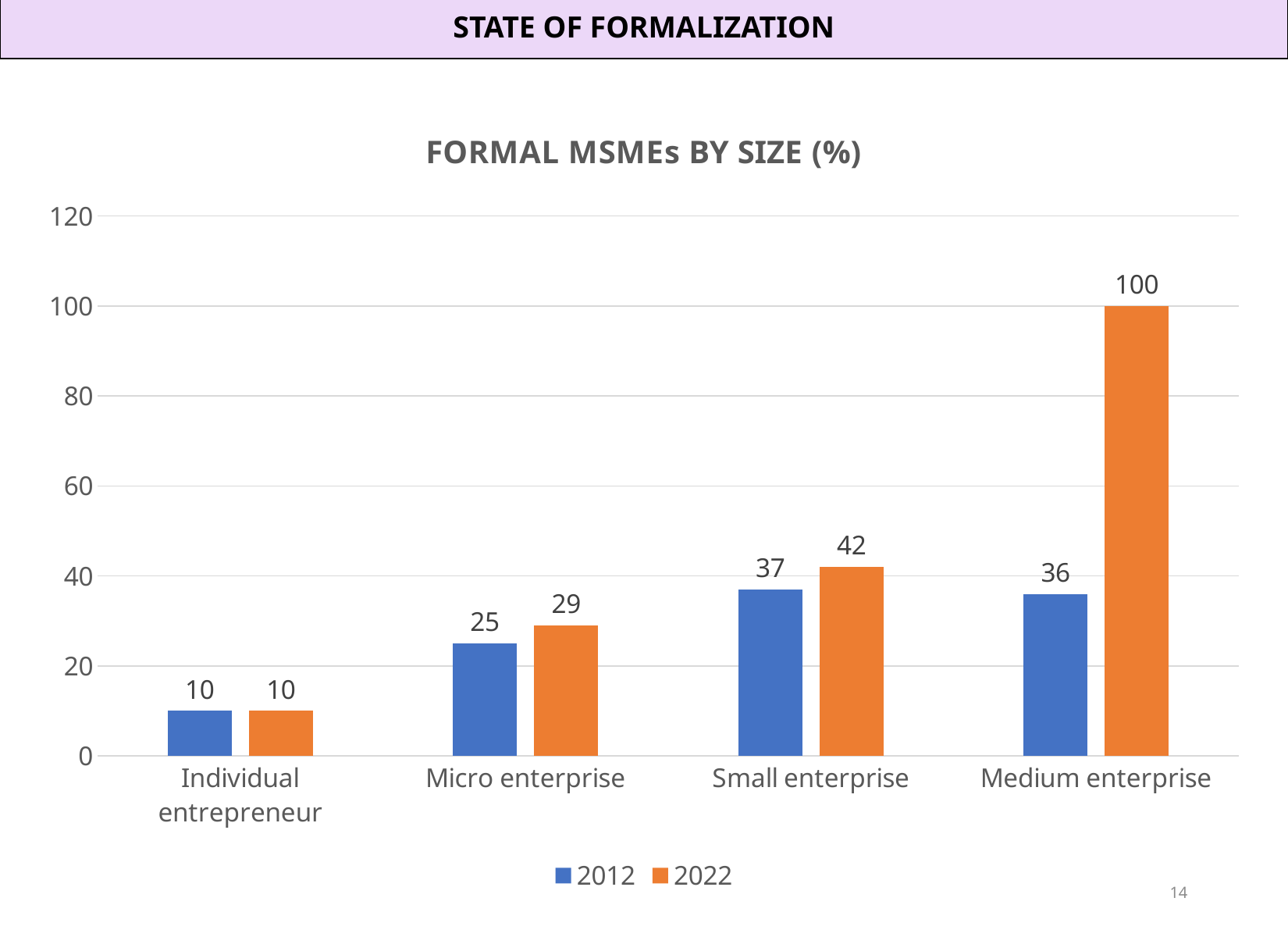
What is the difference between the 2022 and 2012 values for Medium enterprise? 64 Which category has the lowest 2012 value? Individual entrepreneur What is the 2012 value for Small enterprise? 37 Which is larger: the 2012 value for Small enterprise or the 2012 value for Medium enterprise? Small enterprise What kind of chart is shown on the slide? Bar chart What is the 2022 value for Medium enterprise? 100 What is the 2022 value for Micro enterprise? 29 What is the difference between the 2022 and 2012 values for Small enterprise? 5 How many series does the legend list? 2 Which category has the highest 2022 value? Medium enterprise How many categories are shown on the x axis? 4 What is the title of the chart? FORMAL MSMEs BY SIZE (%)